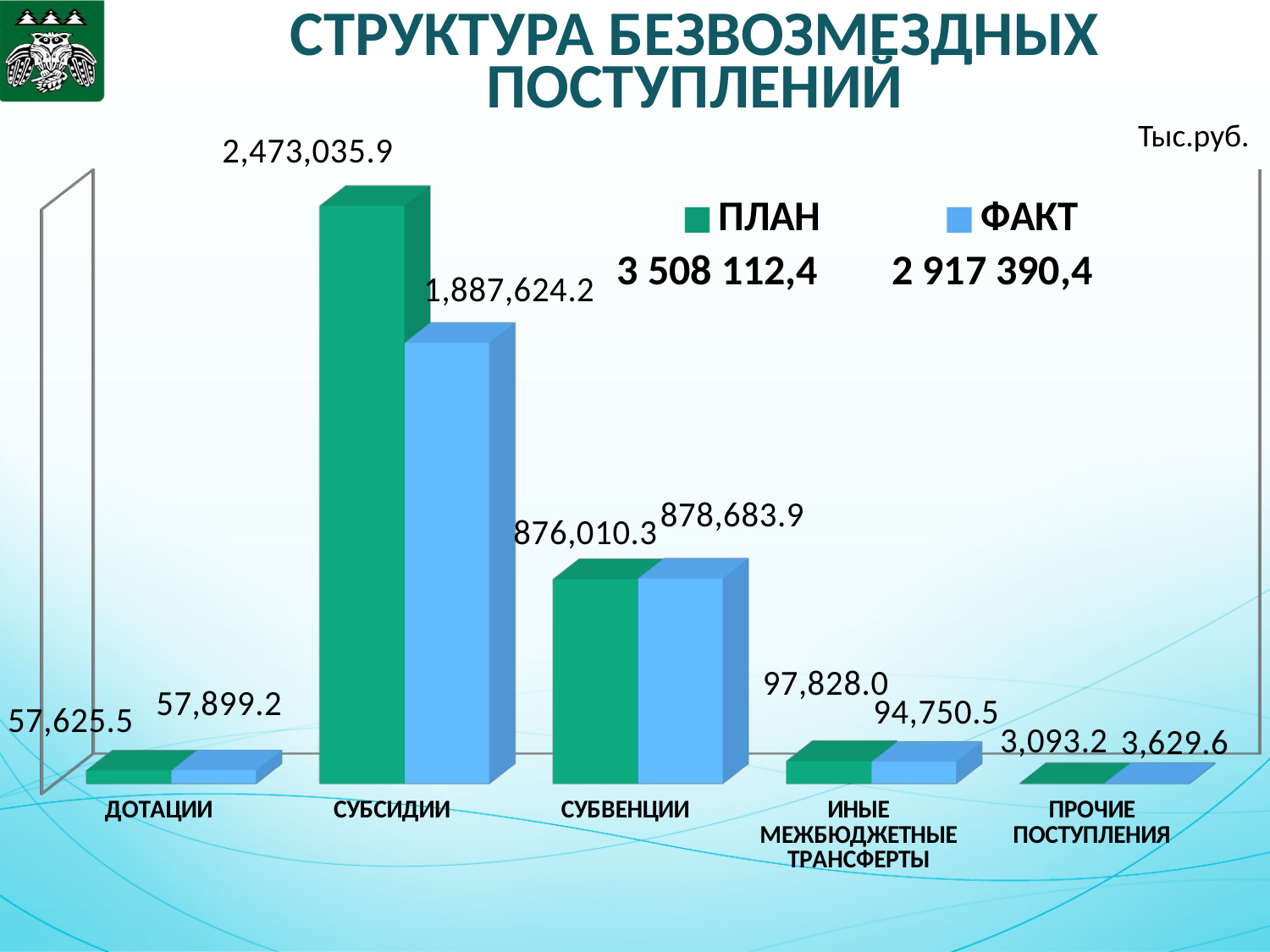
For СУБСИДИИ, which is larger, the ПЛАН value or the ФАКТ value? ПЛАН How many series does the legend list? 2 What is the ФАКТ value for ПРОЧИЕ ПОСТУПЛЕНИЯ? 3,629.6 Which category has the lowest ФАКТ value? ПРОЧИЕ ПОСТУПЛЕНИЯ How many categories are shown on the x axis? 5 Which category has the highest ПЛАН value? СУБСИДИИ What is the ПЛАН value for ИНЫЕ МЕЖБЮДЖЕТНЫЕ ТРАНСФЕРТЫ? 97,828.0 What is the difference between the ПЛАН and ФАКТ values for СУБСИДИИ? 585,411.7 What is the ПЛАН value for СУБСИДИИ? 2,473,035.9 What is the ФАКТ value for СУБВЕНЦИИ? 878,683.9 What is the ФАКТ value for СУБСИДИИ? 1,887,624.2 What type of chart is shown on the slide? bar chart